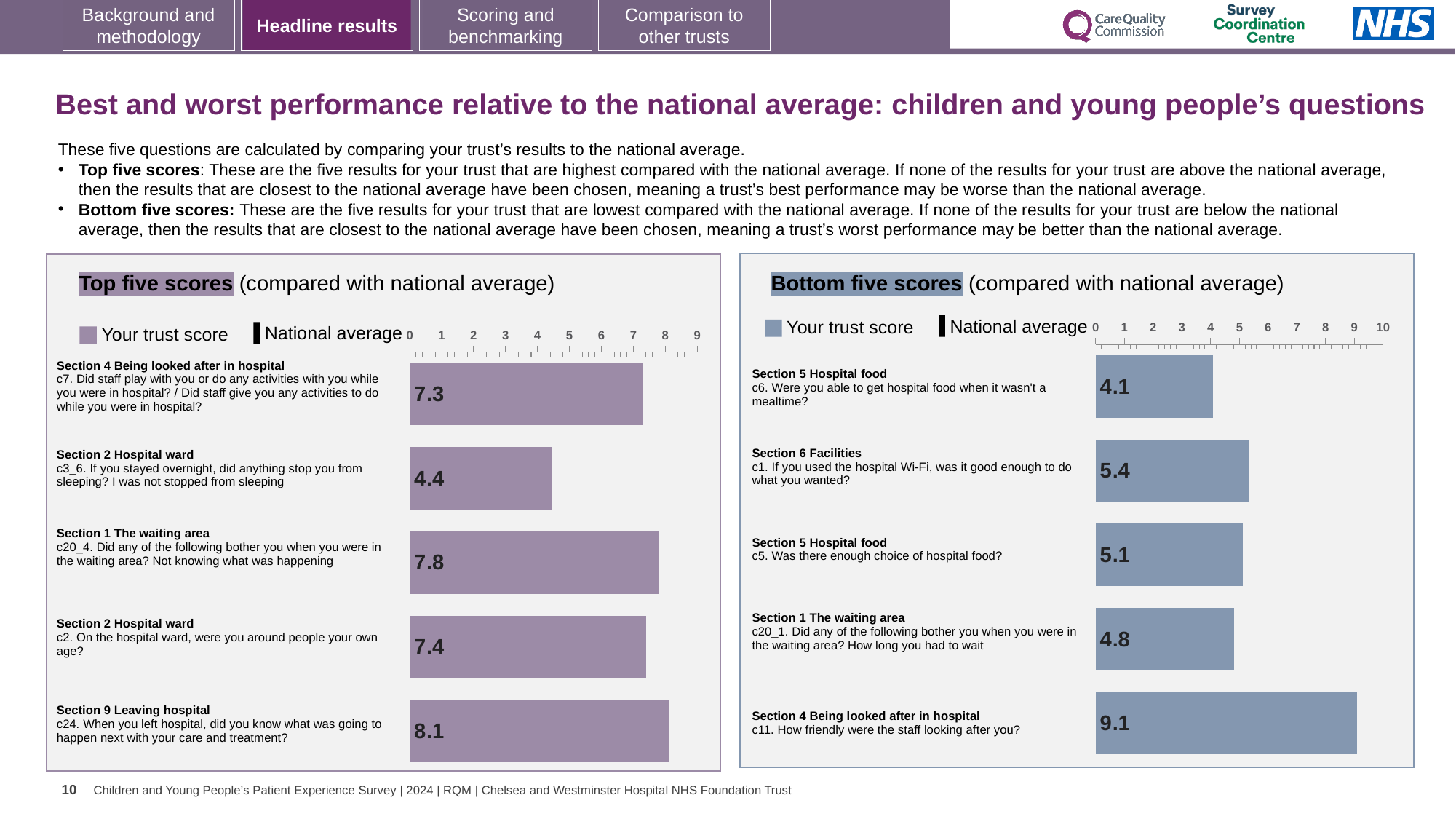
In the Top five scores chart, which question has the lowest trust score? c3_6. If you stayed overnight, did anything stop you from sleeping? In the Bottom five scores chart, which is larger: the trust score for c1 (hospital Wi-Fi) or for c5 (enough choice of hospital food)? c1 (hospital Wi-Fi) In the Bottom five scores chart, what is the trust score for c11 (How friendly were the staff looking after you?)? 9.1 How many questions are plotted in the Bottom five scores chart? 5 In the Top five scores chart, which question has the highest trust score? c24. When you left hospital, did you know what was going to happen next with your care and treatment? In the Top five scores chart, what is the difference between the trust scores for c20_4 (Not knowing what was happening) and c7 (Did staff play with you or do any activities with you)? 0.5 In the Top five scores chart, what is the trust score for c24 (When you left hospital, did you know what was going to happen next with your care and treatment?)? 8.1 In the Bottom five scores chart, which question has the lowest trust score? c6. Were you able to get hospital food when it wasn't a mealtime? In the Top five scores chart, what is the trust score for c3_6 (If you stayed overnight, did anything stop you from sleeping?)? 4.4 What type of chart is the Top five scores chart? Bar chart In the Bottom five scores chart, what is the trust score for c6 (Were you able to get hospital food when it wasn't a mealtime?)? 4.1 In the Bottom five scores chart, what is the difference between the trust scores for c11 (How friendly were the staff) and c20_1 (How long you had to wait)? 4.3